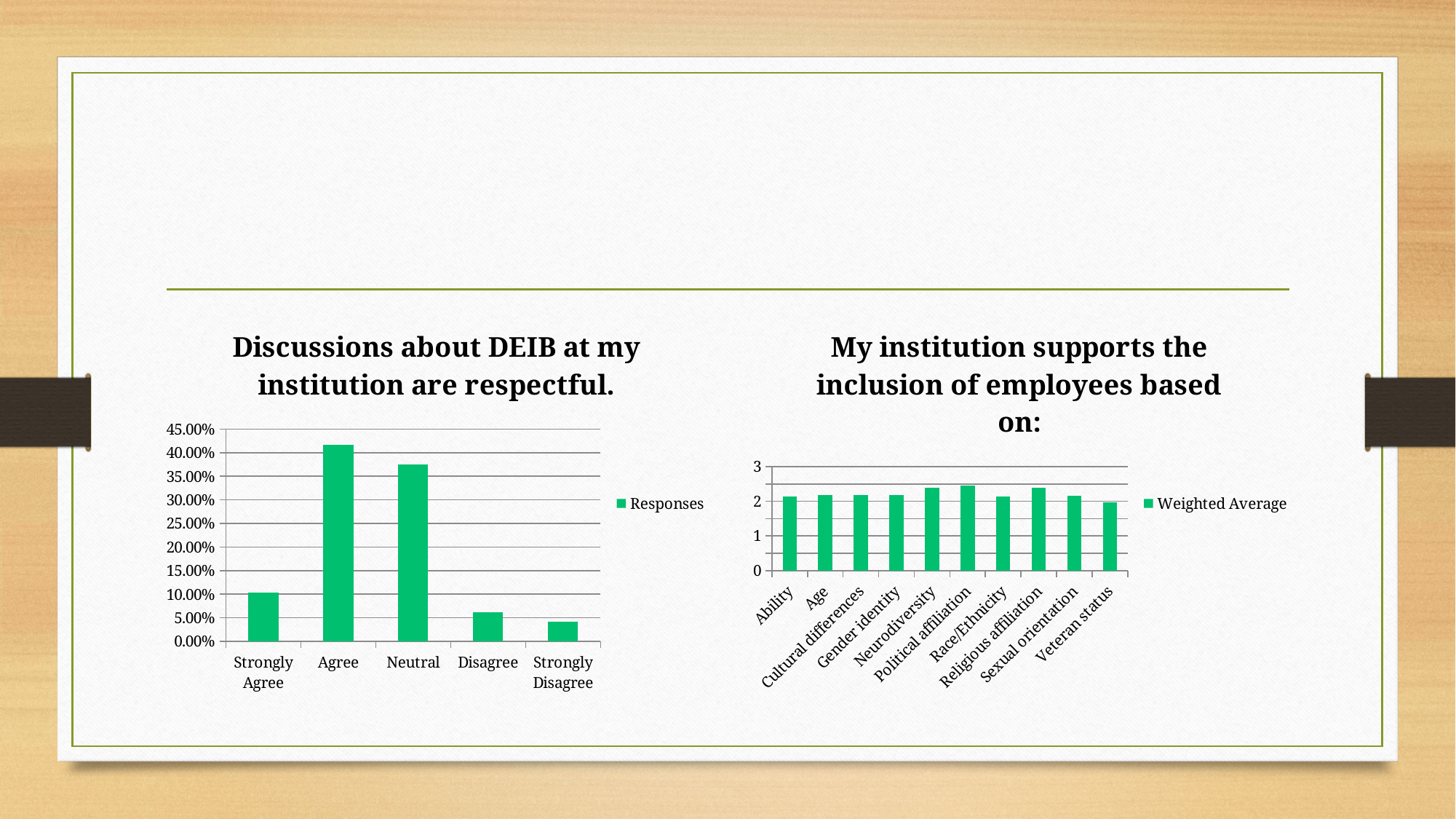
What series name does the legend of the right chart show? Weighted Average On the left chart, is the value for Neutral greater or less than 40.00%? less On the chart titled "Discussions about DEIB at my institution are respectful.", which category has the lowest value? Strongly Disagree On the left chart, is the value for Agree greater or less than 40.00%? greater On the chart titled "Discussions about DEIB at my institution are respectful.", which category has the highest value? Agree What kind of chart is the chart titled "My institution supports the inclusion of employees based on:"? bar chart On the left chart, which is larger, the value for Agree or the value for Neutral? Agree On the left chart, is the value for Strongly Disagree greater or less than 5.00%? less How many categories are shown on the chart titled "Discussions about DEIB at my institution are respectful."? 5 On the chart titled "My institution supports the inclusion of employees based on:", which category has the lowest value? Veteran status How many categories are shown on the chart titled "My institution supports the inclusion of employees based on:"? 10